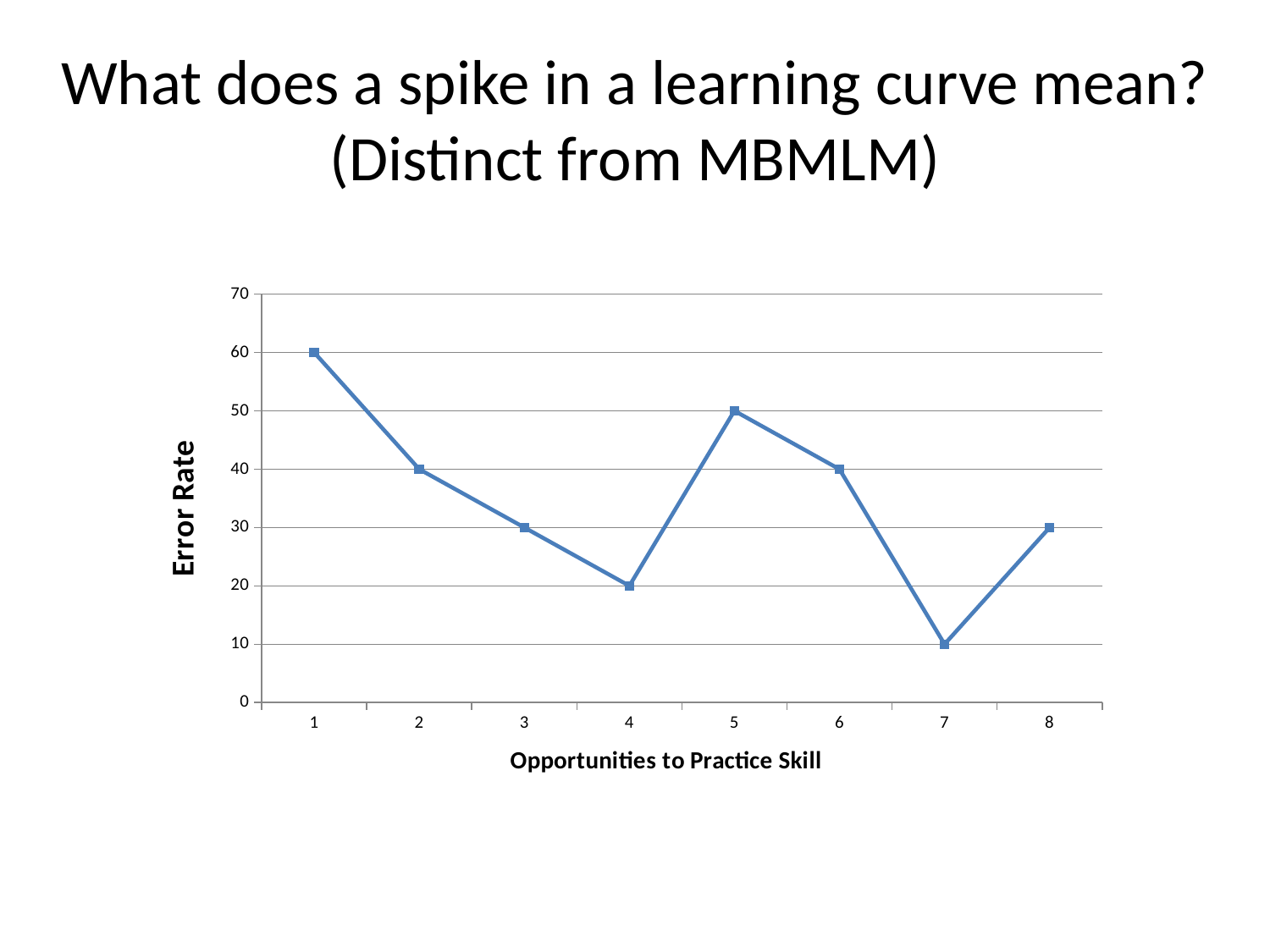
At which opportunity is the error rate lowest? 7 What is the error rate at opportunity 5? 50 What is the error rate at opportunity 1? 60 At which opportunity is the error rate highest? 1 How many opportunities to practice the skill are plotted on the x axis? 8 Which has a higher error rate, opportunity 2 or opportunity 3? Opportunity 2 What is the error rate at opportunity 8? 30 What kind of chart is shown on the slide? Line chart What is the label of the y axis? Error Rate What is the error rate at opportunity 7? 10 Does the error rate rise or fall from opportunity 1 to opportunity 4? Fall What is the difference in error rate between opportunity 4 and opportunity 5? 30